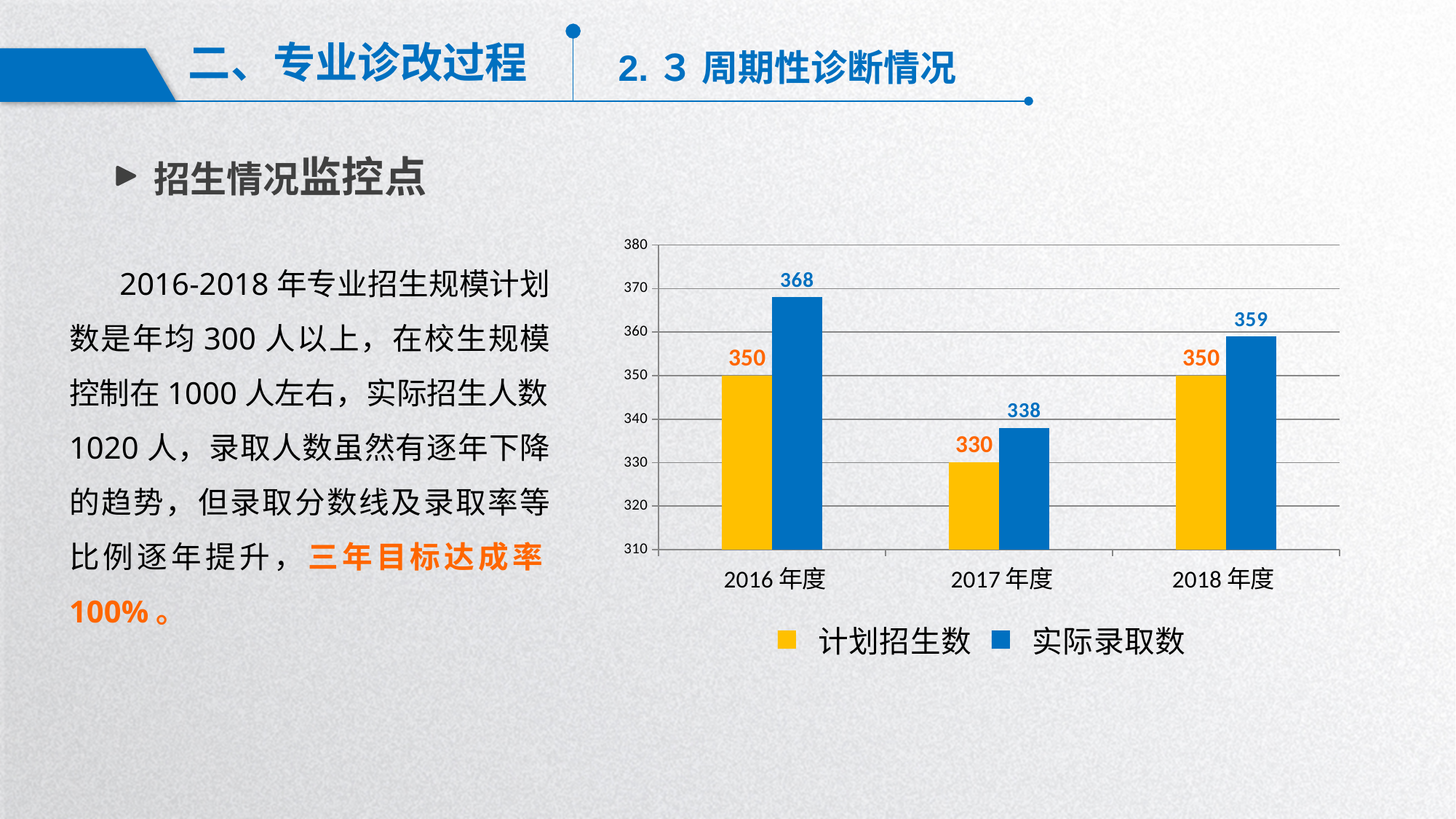
What kind of chart is shown on the slide? bar chart What is the value of 实际录取数 for 2017 年度? 338 How many series does the legend list? 2 Which is larger in 2017 年度, 计划招生数 or 实际录取数? 实际录取数 What is the difference between 实际录取数 in 2016 年度 and 2018 年度? 9 Which year has the highest 实际录取数? 2016 年度 What is the difference between 实际录取数 and 计划招生数 in 2016 年度? 18 Is the value of 实际录取数 for 2016 年度 greater or less than 360? greater How many year categories are shown on the x axis? 3 Which year has the lowest 计划招生数? 2017 年度 What is the value of 实际录取数 for 2018 年度? 359 What is the value of 计划招生数 for 2016 年度? 350